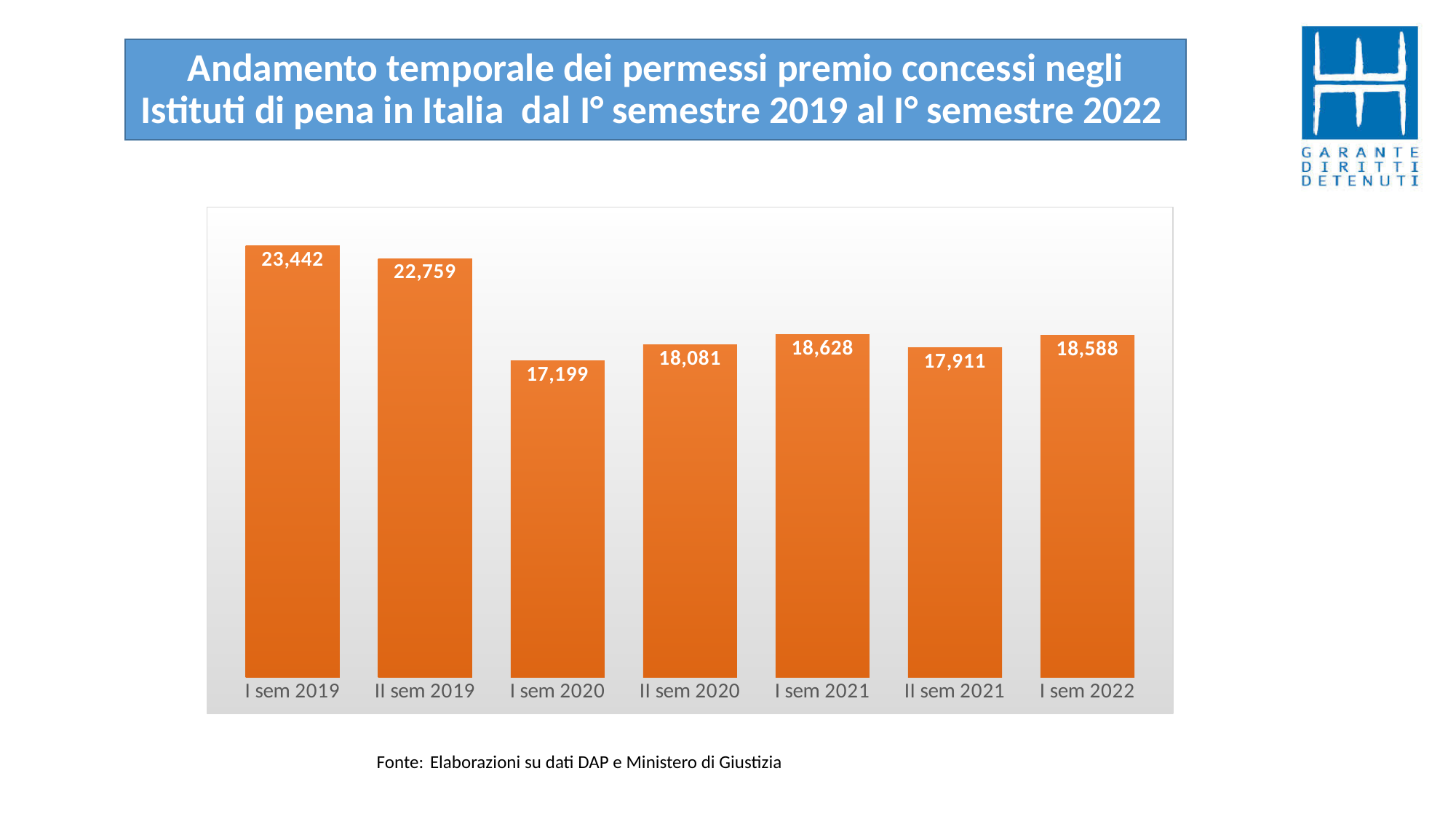
How many semesters are shown on the chart? 7 What is the difference between the values for I sem 2021 and II sem 2021? 717 Do the values rise or fall from I sem 2019 to I sem 2020? fall What kind of chart is shown on the slide? bar chart Which is larger, the value for II sem 2020 or the value for II sem 2021? II sem 2020 What is the value for II sem 2020? 18,081 What is the value for I sem 2022? 18,588 What is the value for I sem 2019? 23,442 Which semester has the lowest value? I sem 2020 What source is cited below the chart? Elaborazioni su dati DAP e Ministero di Giustizia Which semester has the highest value? I sem 2019 What is the difference between the values for I sem 2019 and II sem 2019? 683